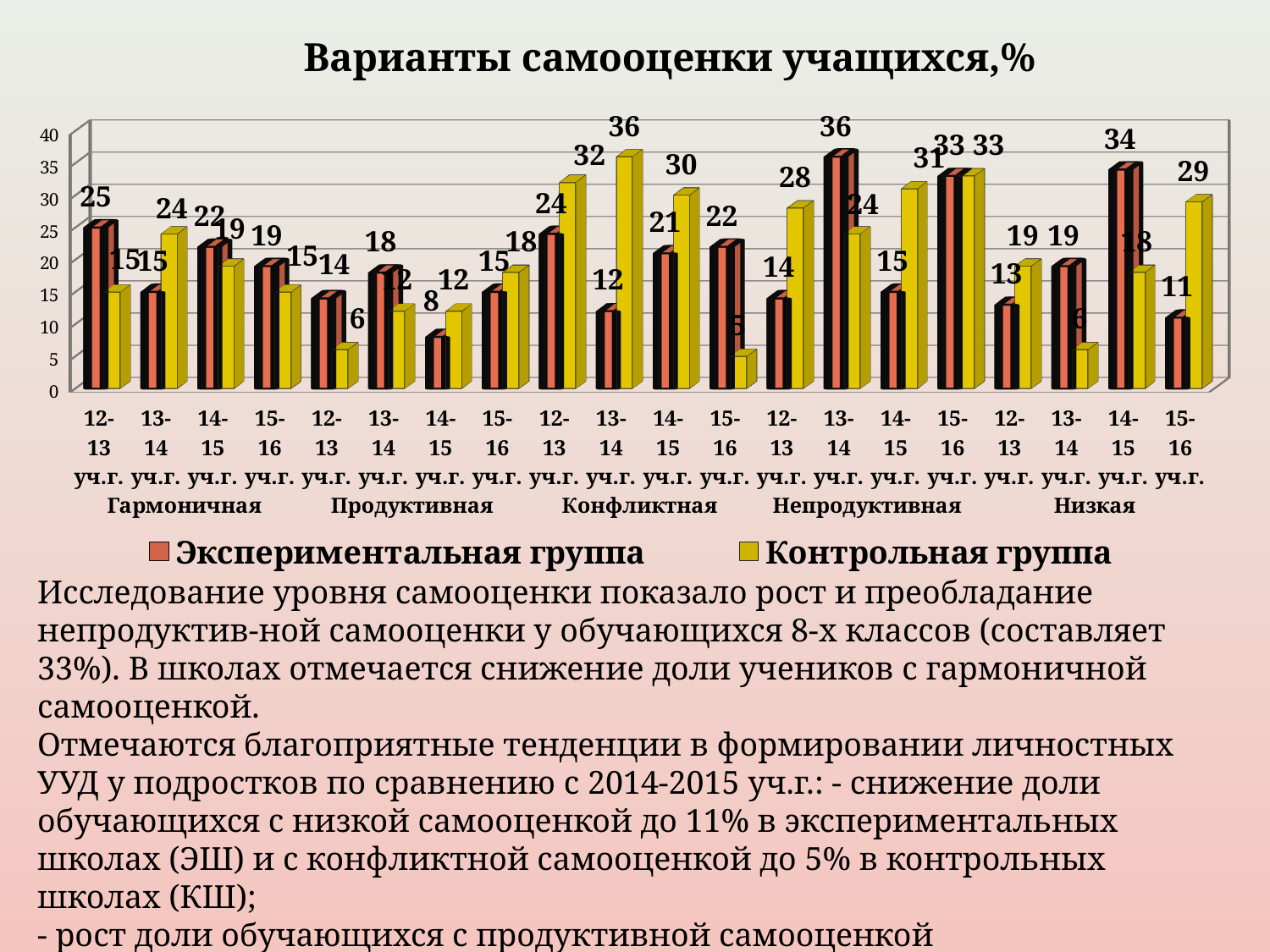
In the Непродуктивная category, which year has the highest value for the Экспериментальная группа? 13-14 уч.г. What is the title of the chart? Варианты самооценки учащихся,% What is the value for the Экспериментальная группа in the Гармоничная category for 12-13 уч.г.? 25 In the Продуктивная category, which year has the lowest value for the Контрольная группа? 12-13 уч.г. What is the value for the Контрольная группа in the Конфликтная category for 13-14 уч.г.? 36 What is the value for the Контрольная группа in the Конфликтная category for 15-16 уч.г.? 5 What is the difference between the Контрольная группа and the Экспериментальная группа in the Конфликтная category for 13-14 уч.г.? 24 What kind of chart is shown on the slide? Bar chart How many self-esteem categories are shown along the x axis? 5 In the Низкая category for 14-15 уч.г., which group has the larger value? Экспериментальная группа What is the value for the Экспериментальная группа in the Низкая category for 15-16 уч.г.? 11 How many series does the legend list? 2